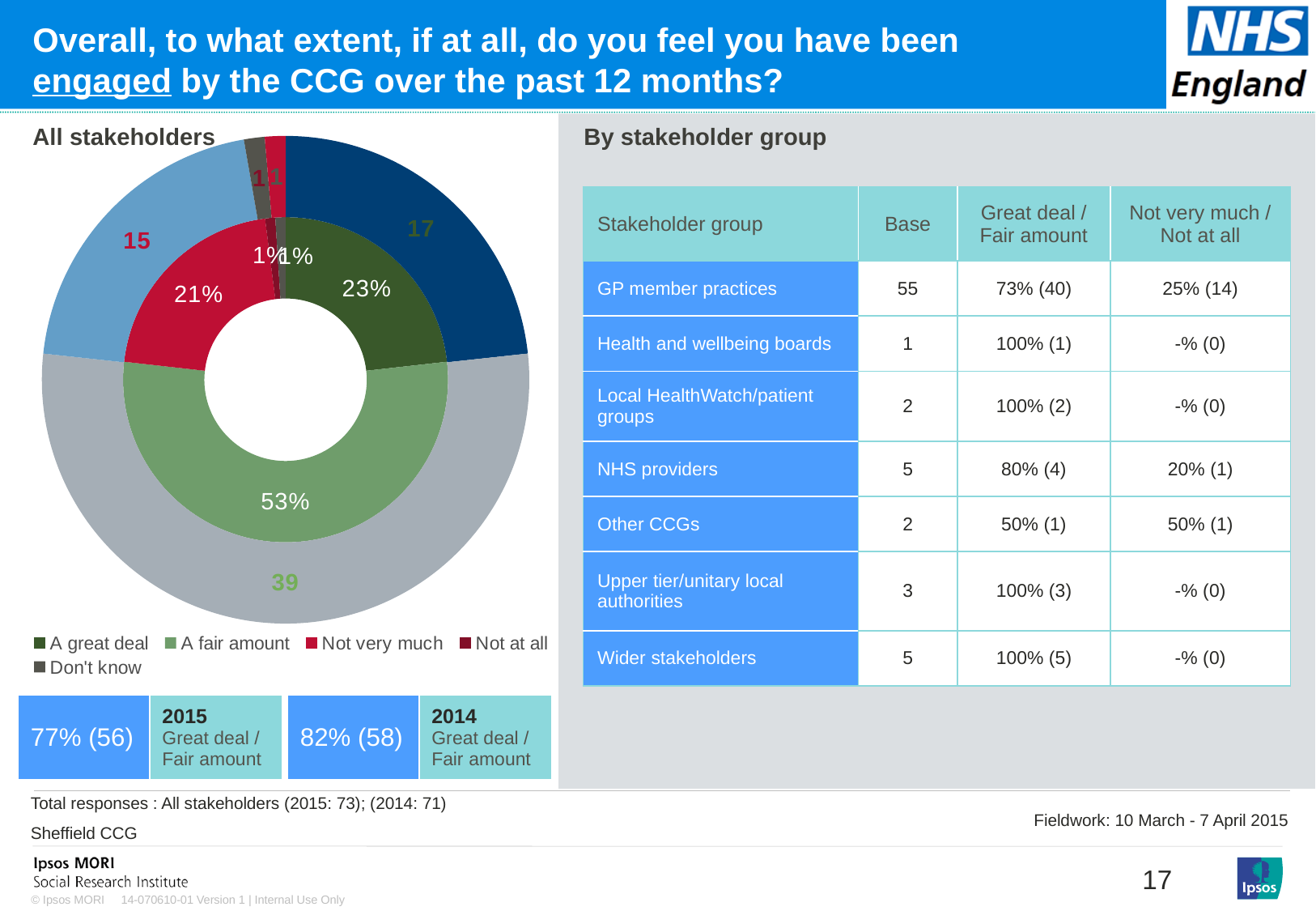
In the 'All stakeholders' chart, what is the count shown on the outer ring for 'A great deal'? 17 In the 'All stakeholders' chart, which response category has the largest share? A fair amount In the 'All stakeholders' chart, what percentage of stakeholders said 'A great deal'? 23% In the 'All stakeholders' chart, what is the count shown on the outer ring for 'A fair amount'? 39 In the 'All stakeholders' chart, what is the difference in percentage points between 'A fair amount' and 'A great deal'? 30 In the 'All stakeholders' chart, what percentage of stakeholders said 'Not very much'? 21% In the 'All stakeholders' chart, which is larger: the share for 'A great deal' or the share for 'Not very much'? A great deal How many response categories does the legend of the 'All stakeholders' chart list? 5 What kind of chart is the 'All stakeholders' chart? Doughnut chart In the 'All stakeholders' chart, what colour represents 'Not very much' in the legend? Red In the 'All stakeholders' chart, what is the combined percentage for 'A great deal' and 'A fair amount'? 76% In the 'All stakeholders' chart, what percentage of stakeholders said 'A fair amount'? 53%